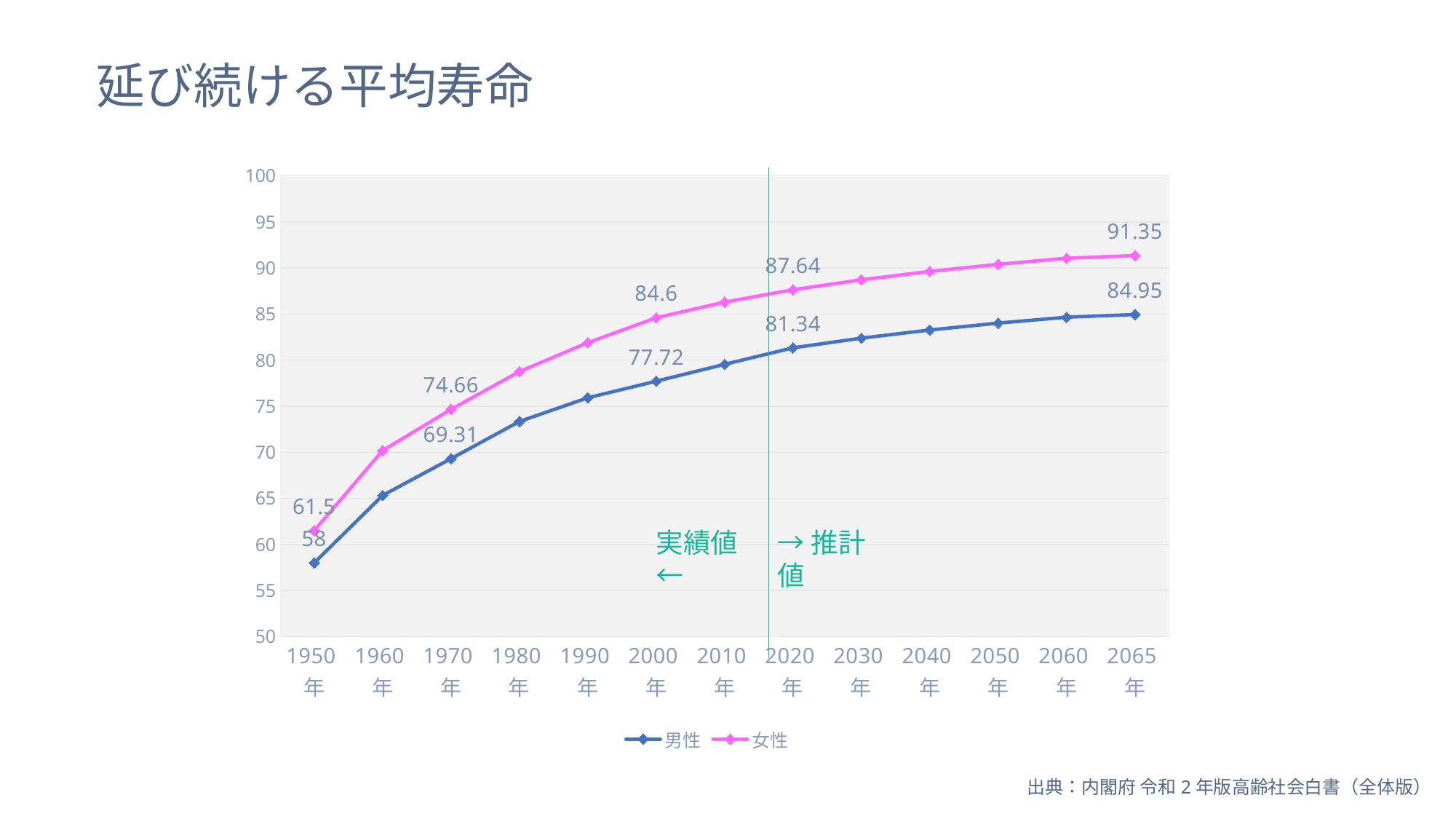
Is the value for 男性 in 1980年 greater or less than 75? less What kind of chart is shown on the slide? line chart What is the value for 女性 in 2000年? 84.6 Which is larger in 2020年, the 男性 value or the 女性 value? 女性 Is the value for 女性 in 2040年 greater or less than 85? greater How many series does the legend list? 2 What is the difference between the 女性 and 男性 values in 1970年? 5.35 What is the value for 女性 in 2065年? 91.35 What is the value for 男性 in 2020年? 81.34 What is the value for 男性 in 1950年? 58 What is the difference between the 女性 and 男性 values in 2065年? 6.4 How many years are shown on the x axis? 13